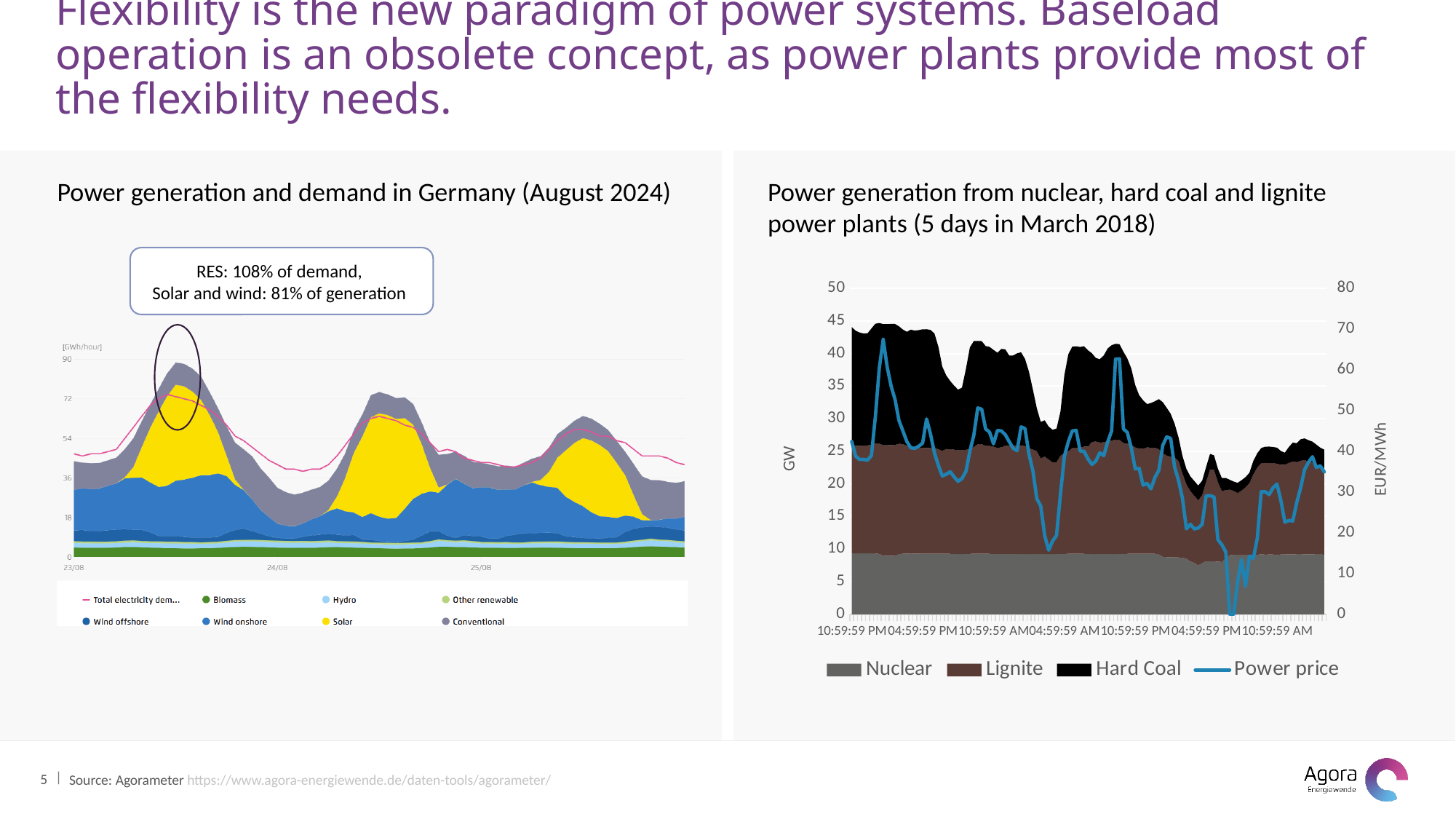
In the right-hand chart, which series is plotted as a line rather than an area? Power price In the right-hand chart, does the total stacked generation from nuclear, lignite and hard coal rise or fall from the start to the end of the period? fall According to the annotation on the left-hand chart, what share of generation came from solar and wind? 81% How many entries does the legend of the right-hand chart list? 4 How many entries does the legend of the left-hand chart 'Power generation and demand in Germany (August 2024)' list? 8 In the right-hand chart, is the total generation from nuclear, lignite and hard coal at the start of the period greater or less than 40 GW? greater In the left-hand chart, is the peak of total generation on 23/08 greater or less than 72 GWh/hour? greater In the right-hand chart, is the Nuclear generation at any point greater or less than 15 GW? less What unit is shown on the right-hand vertical axis of the right-hand chart? EUR/MWh What kind of chart is the 'Power generation from nuclear, hard coal and lignite power plants' chart on the right? stacked area chart with a line In the left-hand chart, which series is drawn as a line rather than a stacked area? Total electricity demand